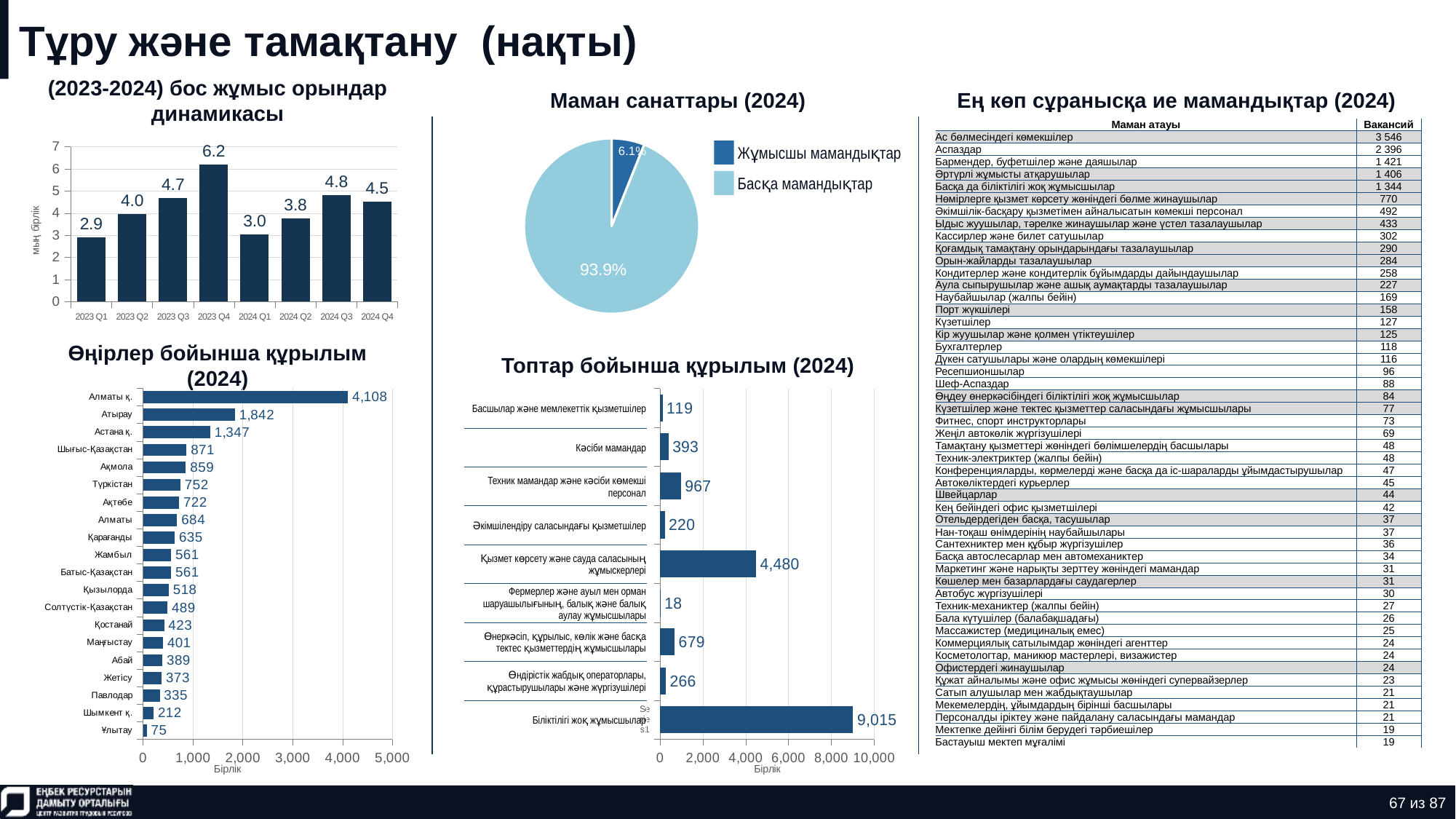
In the chart '(2023-2024) бос жұмыс орындар динамикасы', what is the value for 2023 Q4? 6.2 In the chart 'Топтар бойынша құрылым (2024)', what is the value for 'Кәсіби мамандар'? 393 In the chart 'Өңірлер бойынша құрылым (2024)', what is the value for Атырау? 1,842 In the pie chart 'Маман санаттары (2024)', what share does 'Басқа мамандықтар' have? 93.9% What kind of chart is 'Топтар бойынша құрылым (2024)'? Bar chart In the chart 'Өңірлер бойынша құрылым (2024)', which region has the highest value? Алматы қ. In the chart '(2023-2024) бос жұмыс орындар динамикасы', what is the difference between 2024 Q3 and 2024 Q1? 1.8 In the chart '(2023-2024) бос жұмыс орындар динамикасы', how many quarters are plotted? 8 In the chart 'Топтар бойынша құрылым (2024)', which group has the lowest value? Фермерлер және ауыл мен орман шаруашылығының, балық және балық аулау жұмысшылары In the pie chart 'Маман санаттары (2024)', how many series does the legend list? 2 In the chart 'Өңірлер бойынша құрылым (2024)', which is larger, Ақмола or Түркістан? Ақмола In the chart '(2023-2024) бос жұмыс орындар динамикасы', which quarter has the lowest value? 2023 Q1